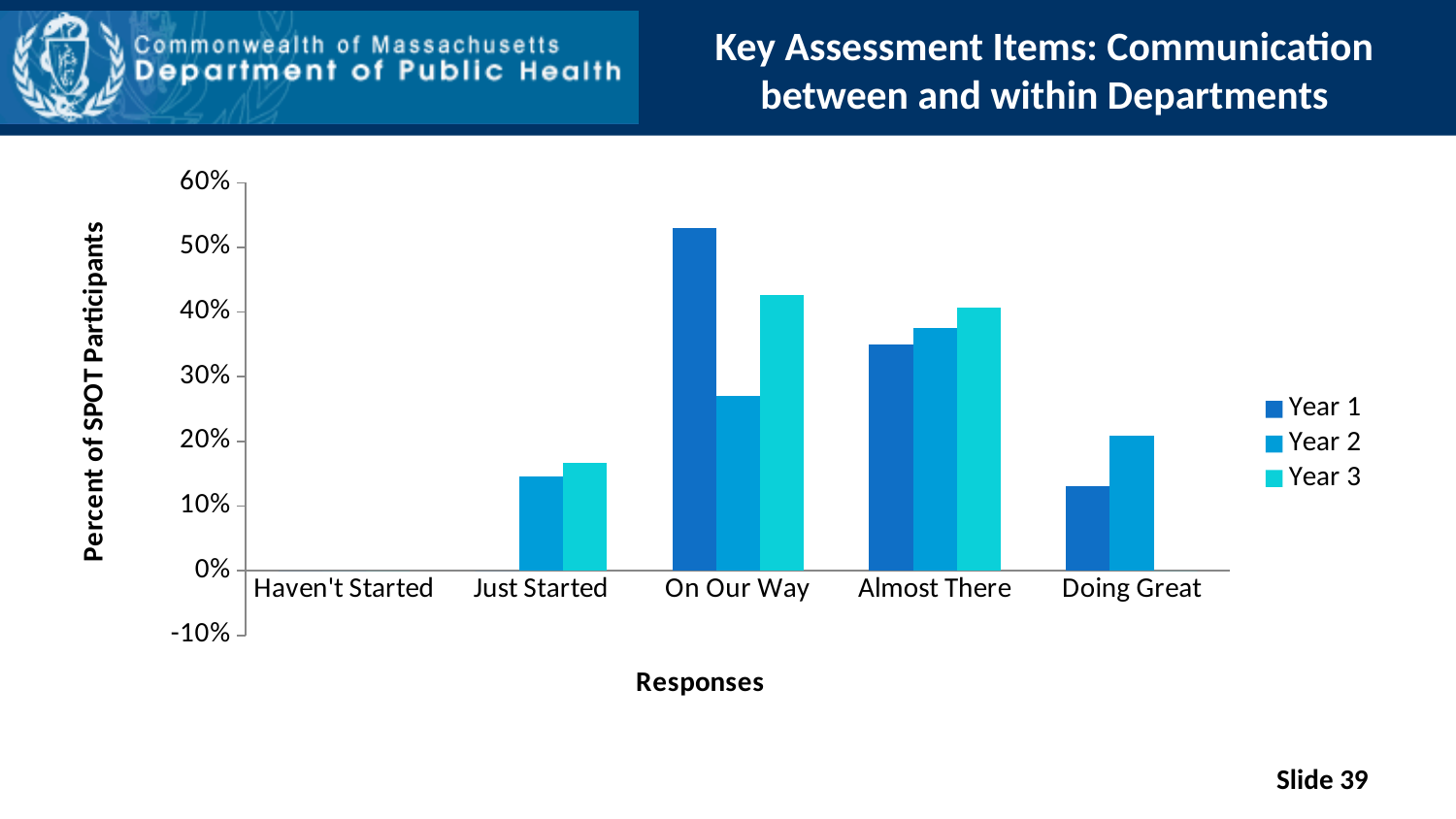
Is the Year 2 value for On Our Way greater or less than 30%? less How many series does the legend list? 3 For Year 1, which response category has the highest value? On Our Way For On Our Way, which is larger: the Year 1 value or the Year 2 value? Year 1 For Almost There, which is larger: the Year 1 value or the Year 3 value? Year 3 Is the Year 1 value for On Our Way greater or less than 50%? greater Is the Year 1 value for Doing Great greater or less than 20%? less What kind of chart is shown on the slide? bar chart What is the title of the horizontal axis? Responses What is the title of the vertical axis? Percent of SPOT Participants How many response categories are shown on the x axis? 5